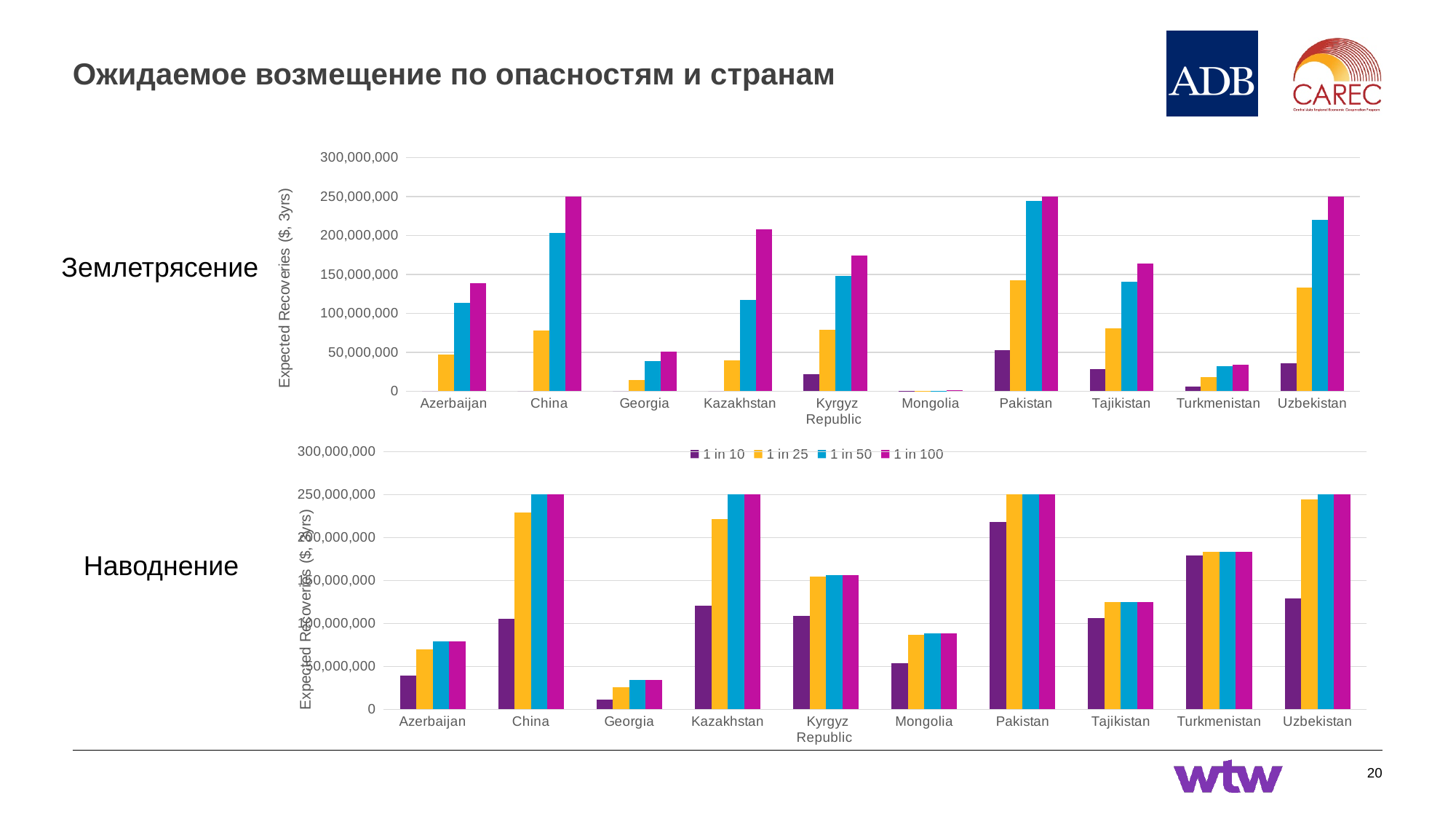
In the top chart (Землетрясение), which country has the highest value for the 1 in 10 series? Pakistan What is the y-axis label of the top chart (Землетрясение)? Expected Recoveries ($, 3yrs) In the top chart (Землетрясение), is the 1 in 50 value for China larger or smaller than the 1 in 50 value for Kazakhstan? larger What kind of chart is the top chart (Землетрясение)? bar chart In the bottom chart (Наводнение), is the 1 in 100 value for Georgia greater or less than 50,000,000? less In the top chart (Землетрясение), which country has the lowest value for the 1 in 100 series? Mongolia In the top chart (Землетрясение), is the 1 in 50 value for Azerbaijan greater or less than 100,000,000? greater In the bottom chart (Наводнение), which is larger: the 1 in 25 value for Kazakhstan or the 1 in 25 value for Kyrgyz Republic? Kazakhstan How many series does the legend list for the charts? 4 How many countries are shown on the x axis of the bottom chart (Наводнение)? 10 In the bottom chart (Наводнение), which country has the lowest value for the 1 in 10 series? Georgia In the bottom chart (Наводнение), is the 1 in 10 value for Turkmenistan greater or less than 150,000,000? greater